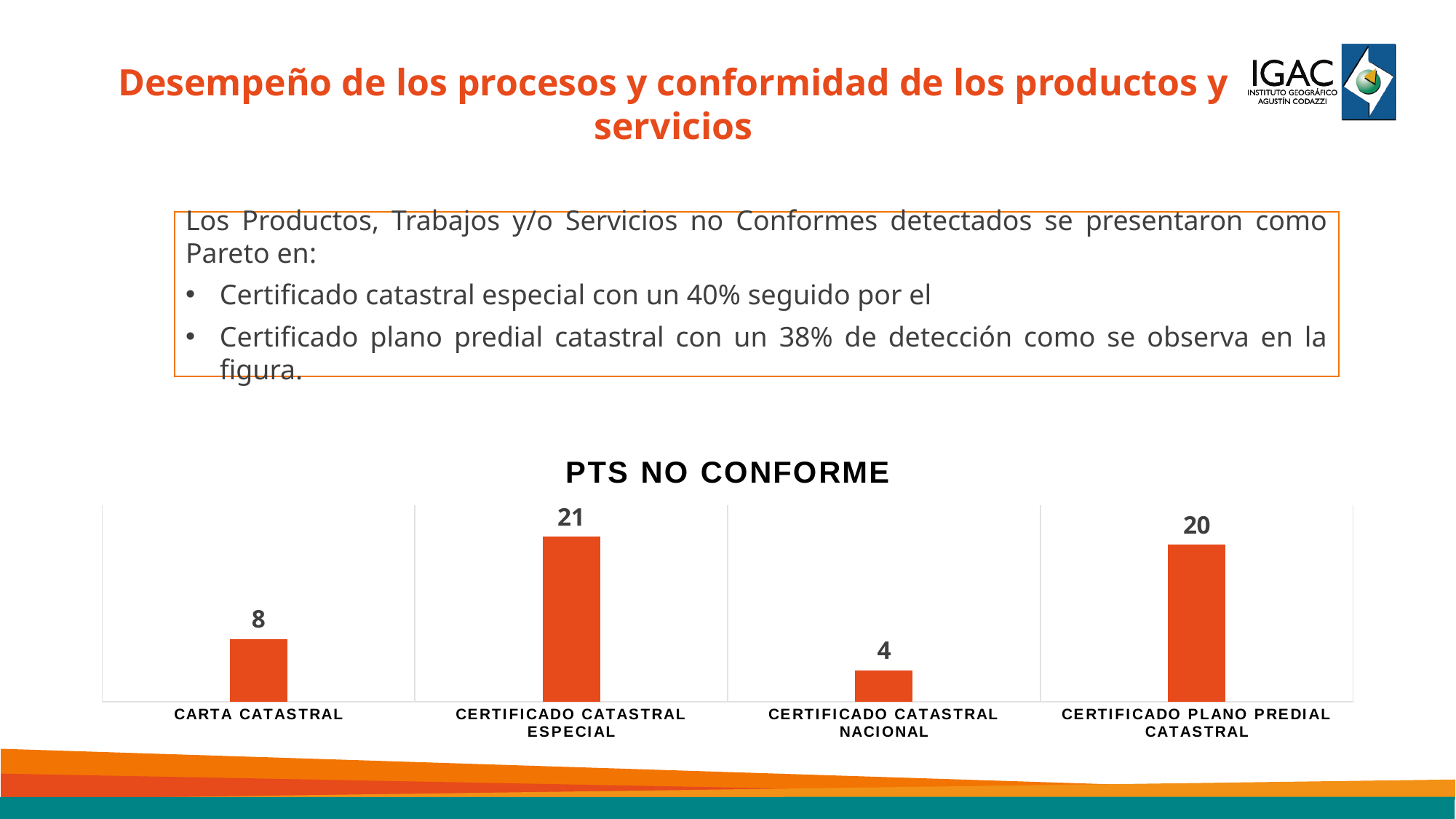
What is the value for Carta Catastral in the PTS NO CONFORME chart? 8 What is the difference between the values for Certificado Catastral Especial and Carta Catastral? 13 Which is larger, the value for Carta Catastral or the value for Certificado Catastral Nacional? Carta Catastral Which category has the highest value in the chart? Certificado Catastral Especial What is the value for Certificado Plano Predial Catastral? 20 What is the value for Certificado Catastral Nacional? 4 How many categories are shown in the chart? 4 What is the value for Certificado Catastral Especial? 21 What is the difference between the values for Certificado Plano Predial Catastral and Certificado Catastral Nacional? 16 What is the title of the chart? PTS NO CONFORME What kind of chart is shown on the slide? Bar chart Which category has the lowest value in the chart? Certificado Catastral Nacional